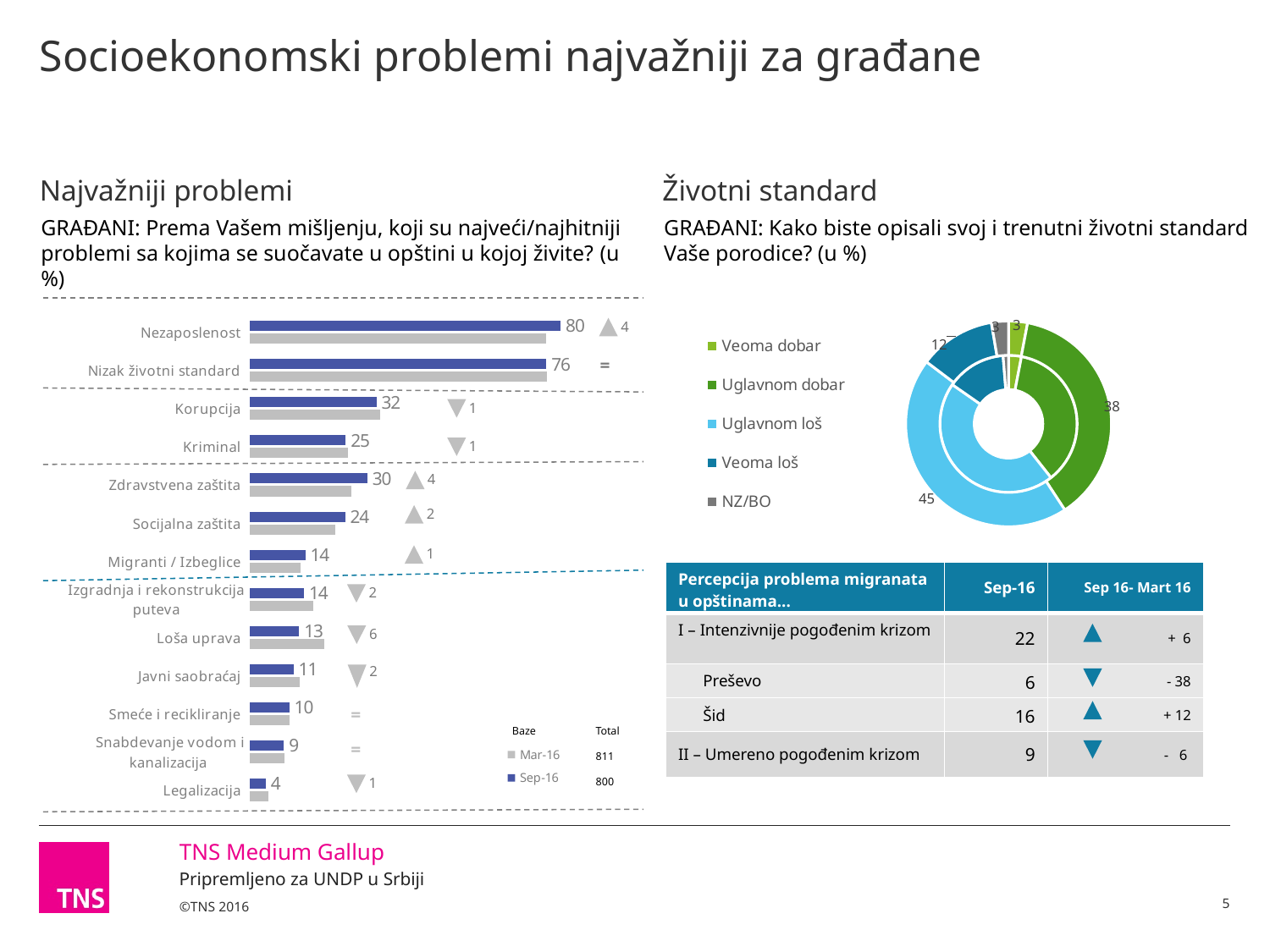
How many categories does the legend of the 'Životni standard' doughnut chart list? 5 In the 'Životni standard' chart, what is the value labelled for Uglavnom loš on the outer ring? 45 What kind of chart is used for 'Najvažniji problemi'? Bar chart In the 'Najvažniji problemi' bar chart, what is the Sep-16 value for Nezaposlenost? 80 How many categories are shown in the 'Najvažniji problemi' bar chart? 13 In the 'Najvažniji problemi' bar chart, which category has the lowest Sep-16 value? Legalizacija In the 'Najvažniji problemi' bar chart, what is the Sep-16 value for Korupcija? 32 In the 'Najvažniji problemi' bar chart, which has a larger Sep-16 value, Korupcija or Kriminal? Korupcija In the 'Najvažniji problemi' bar chart, which category has the highest Sep-16 value? Nezaposlenost In the 'Najvažniji problemi' bar chart, what is the Sep-16 value for Zdravstvena zaštita? 30 How many series does the legend of the 'Najvažniji problemi' bar chart list? 2 In the 'Najvažniji problemi' bar chart, what is the difference between the Sep-16 values for Nezaposlenost and Nizak životni standard? 4